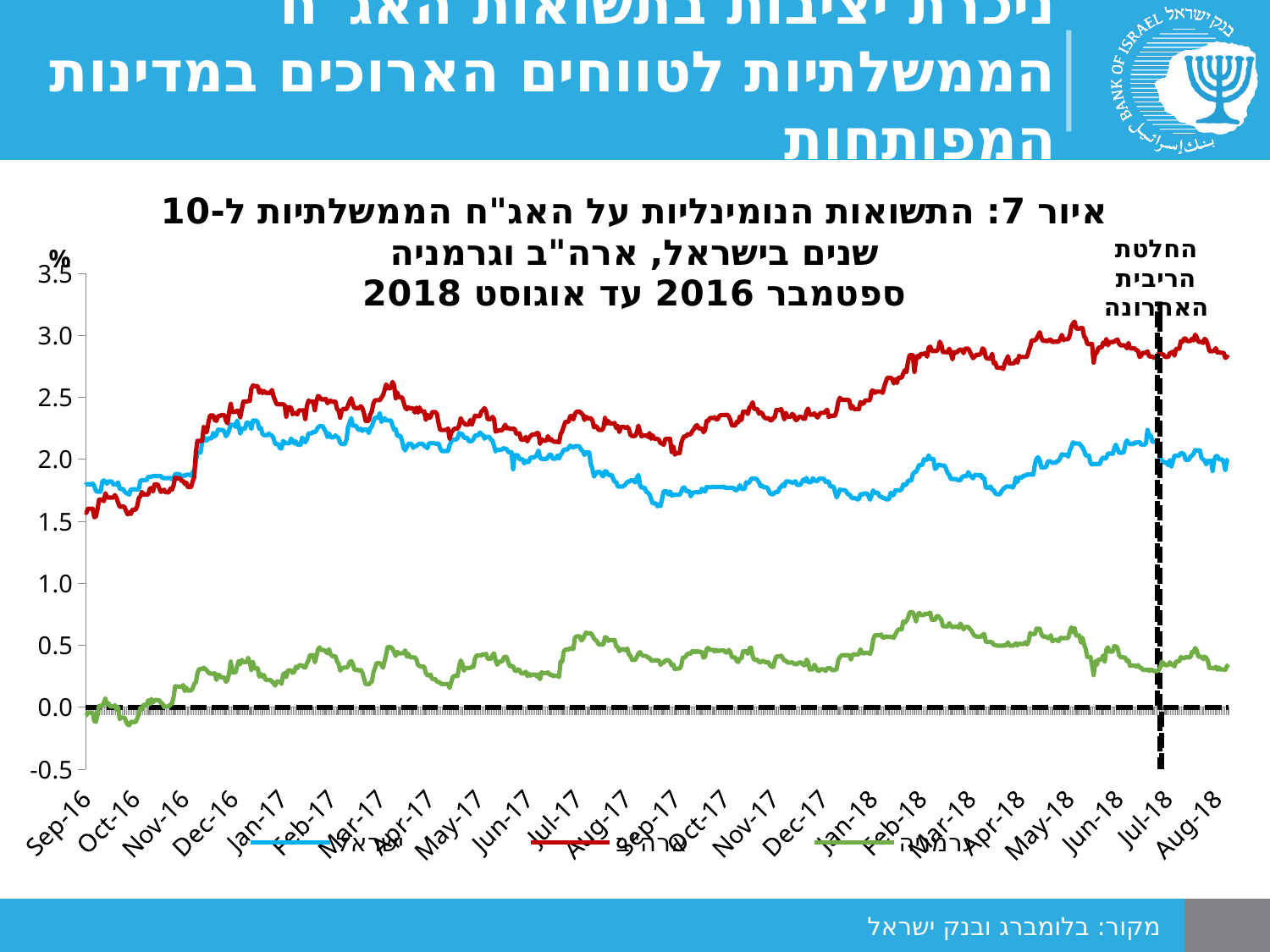
How many month labels are shown on the x axis? 24 How many series (lines) does the chart plot? 3 Which line is the lowest throughout the whole period? the green line (Germany) Is the value of the blue line (Israel) in Sep-16 greater or less than 2.0? less Which line is the highest at the end of the period (Aug-18)? the red line (US) Is the value of the green line (Germany) in Sep-16 greater or less than 0.5? less In Sep-16, which is higher: the blue line (Israel) or the red line (US)? the blue line (Israel) What does the vertical dashed line near Jul-18 mark, according to the annotation? החלטת הריבית האחרונה Is the value of the red line (US) in Aug-18 greater or less than 2.5? greater What kind of chart is shown on the slide? line chart Does the red line (US) overall rise or fall from Sep-16 to Aug-18? rise